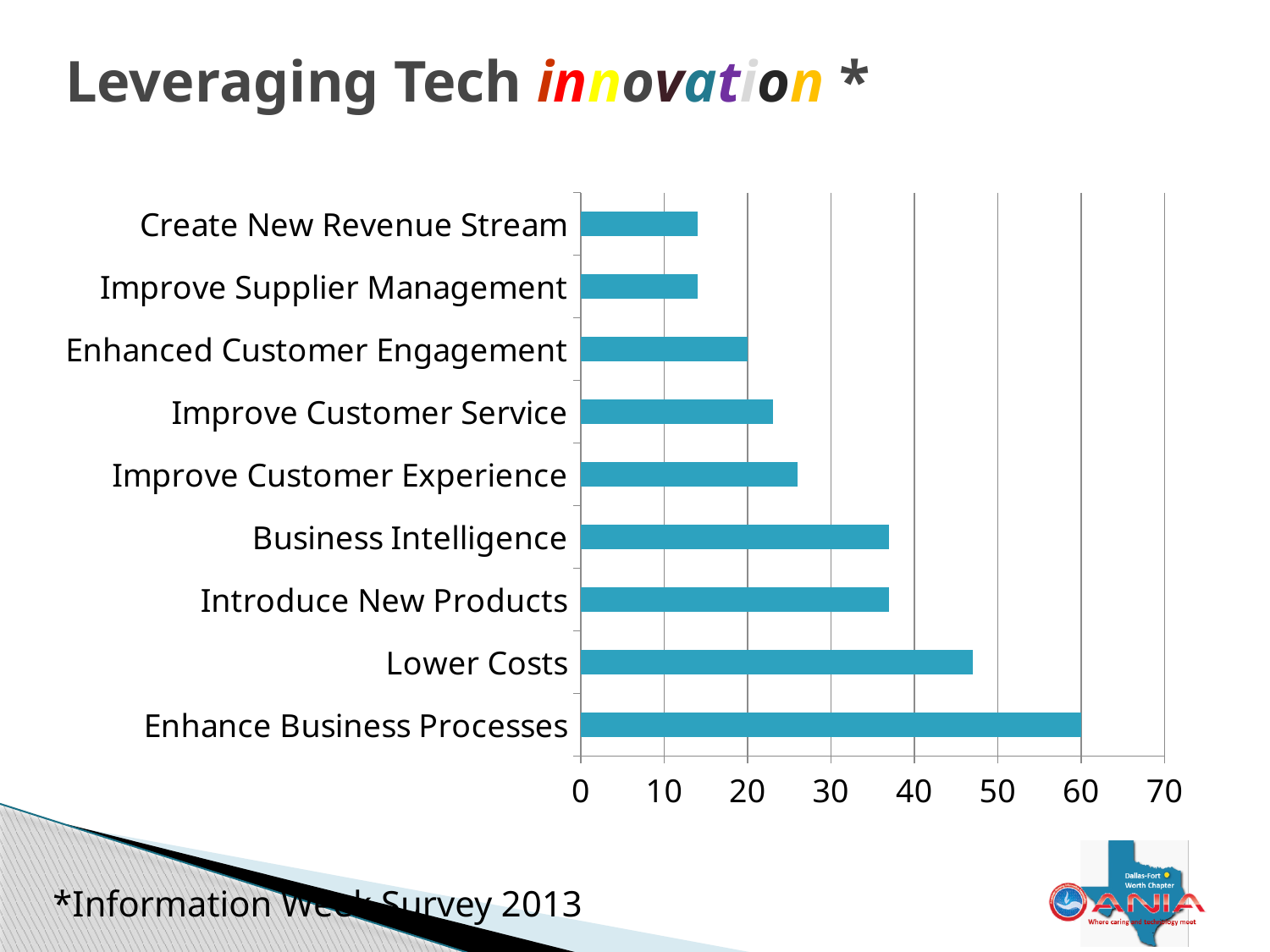
How many categories are plotted in the chart? 9 Is the value for Improve Customer Experience greater or less than 20? greater Is the value for Business Intelligence greater or less than 40? less What is the value for Enhance Business Processes? 60 Which is larger, the value for Lower Costs or the value for Business Intelligence? Lower Costs What kind of chart is shown on the slide? bar chart Is the value for Lower Costs greater or less than 40? greater What is the value for Enhanced Customer Engagement? 20 Which category has the highest value in the chart? Enhance Business Processes What is the title of the slide containing the chart? Leveraging Tech innovation *